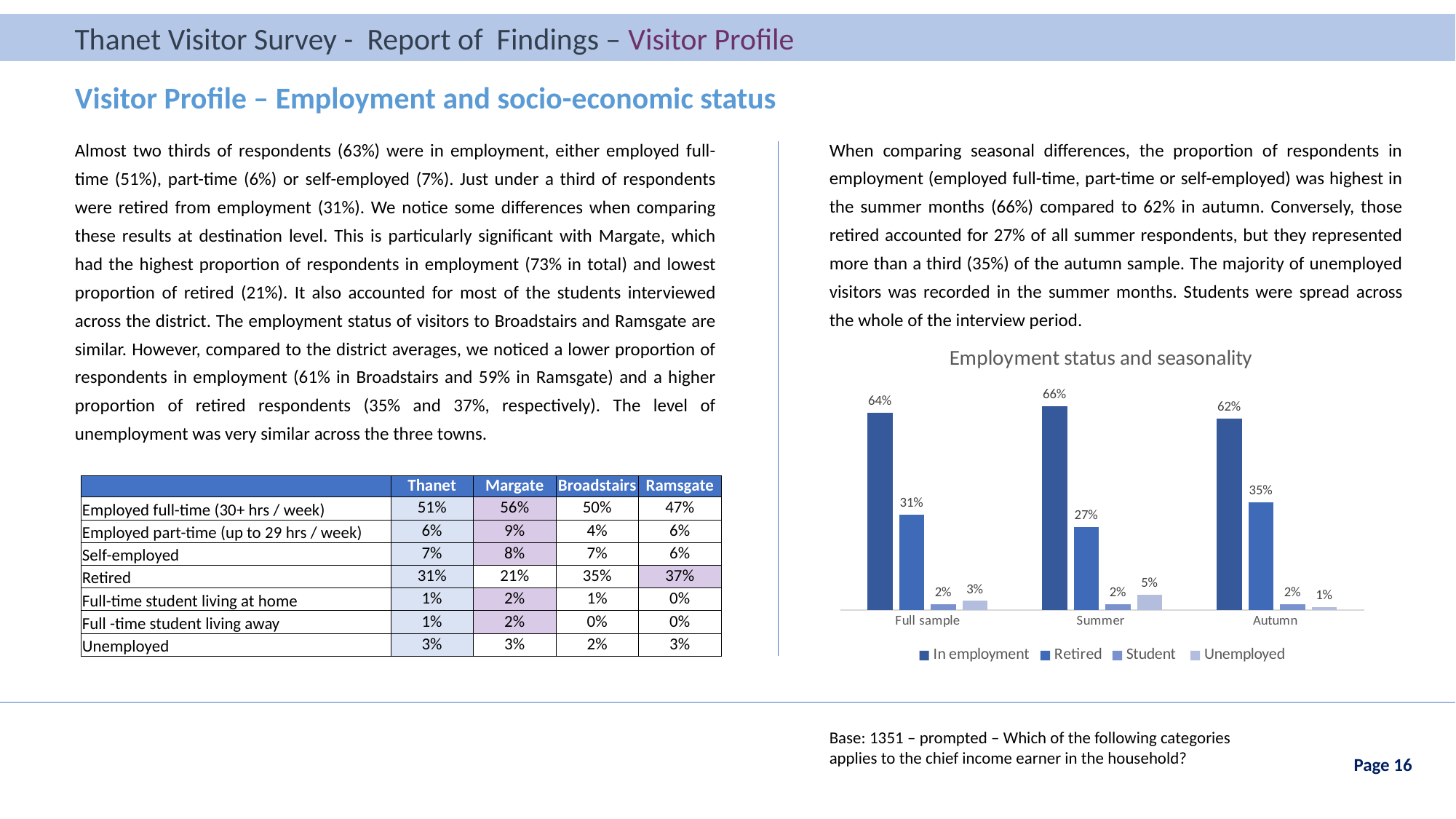
How many series does the legend list? 4 Which is larger: the Retired value for Autumn or the Retired value for Full sample? Autumn Which group has the lowest value for Retired? Summer What is the value for Retired in the Full sample group? 31% What is the value for Retired in the Autumn group? 35% What is the value for Unemployed in the Summer group? 5% What is the value for In employment in the Summer group? 66% What is the title of the chart? Employment status and seasonality Which group has the highest value for In employment? Summer What is the difference between the In employment values for Summer and Autumn? 4% What kind of chart is shown? Bar chart How many groups are shown on the x axis? 3